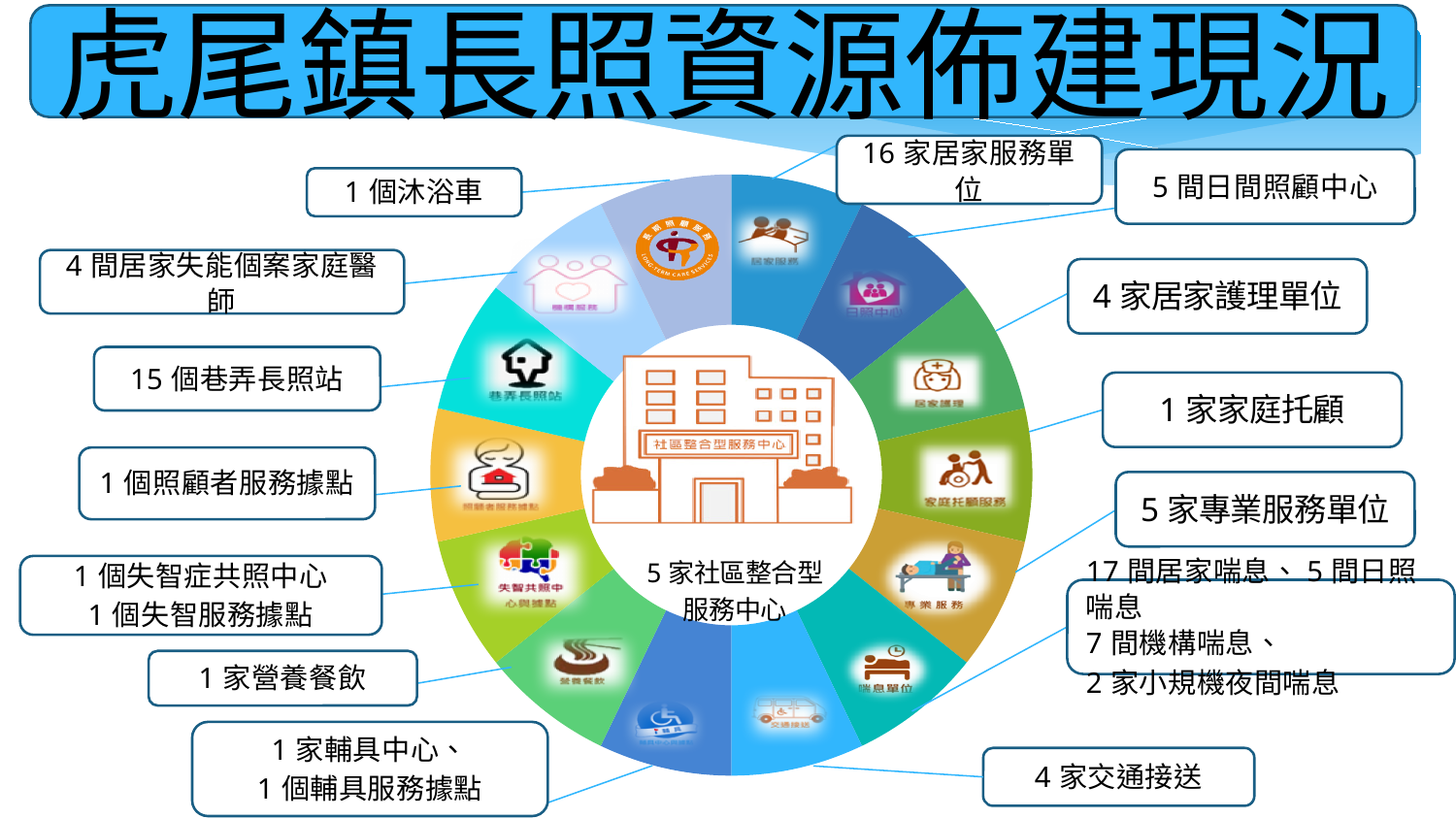
Which has more units according to the slide, 居家服務單位 or 居家護理單位? 居家服務單位 How many 日間照顧中心 does the slide report? 5 間 How many 專業服務單位 does the slide report? 5 家 How many 居家喘息 does the slide report? 17 間 How many 居家服務單位 does the slide report? 16 家 How many 家庭托顧 does the slide report? 1 家 How many 巷弄長照站 does the slide report? 15 個 How many 居家護理單位 does the slide report? 4 家 How many 社區整合型服務中心 are shown in the centre of the ring? 5 家 What is the title of the diagram on the slide? 虎尾鎮長照資源佈建現況 How many 居家失能個案家庭醫師 does the slide report? 4 間 How many 交通接送 does the slide report? 4 家